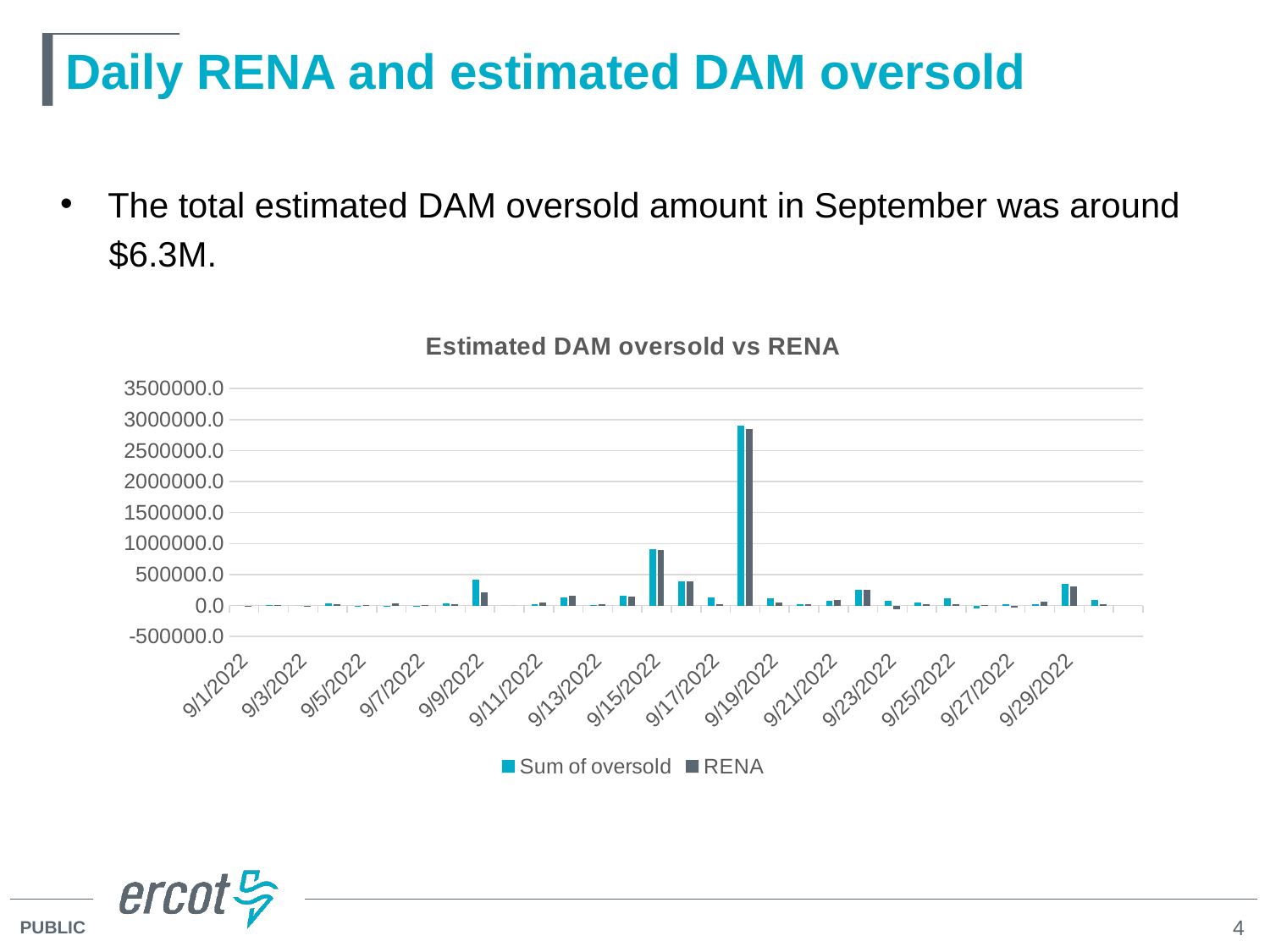
Is the tallest RENA bar in the chart greater or less than 3000000.0? less Which is larger in the chart, the tallest bar near 9/19/2022 or the tallest bar near 9/15/2022? the bar near 9/19/2022 How many date labels are shown along the x axis of the chart? 15 Which series is drawn in blue in the chart? Sum of oversold Is the tallest Sum of oversold bar in the chart greater or less than 2500000.0? greater Is the Sum of oversold bar at 9/15/2022 greater or less than 500000.0? greater What kind of chart is shown on the slide? bar chart What is the title of the chart? Estimated DAM oversold vs RENA How many series does the legend of the chart list? 2